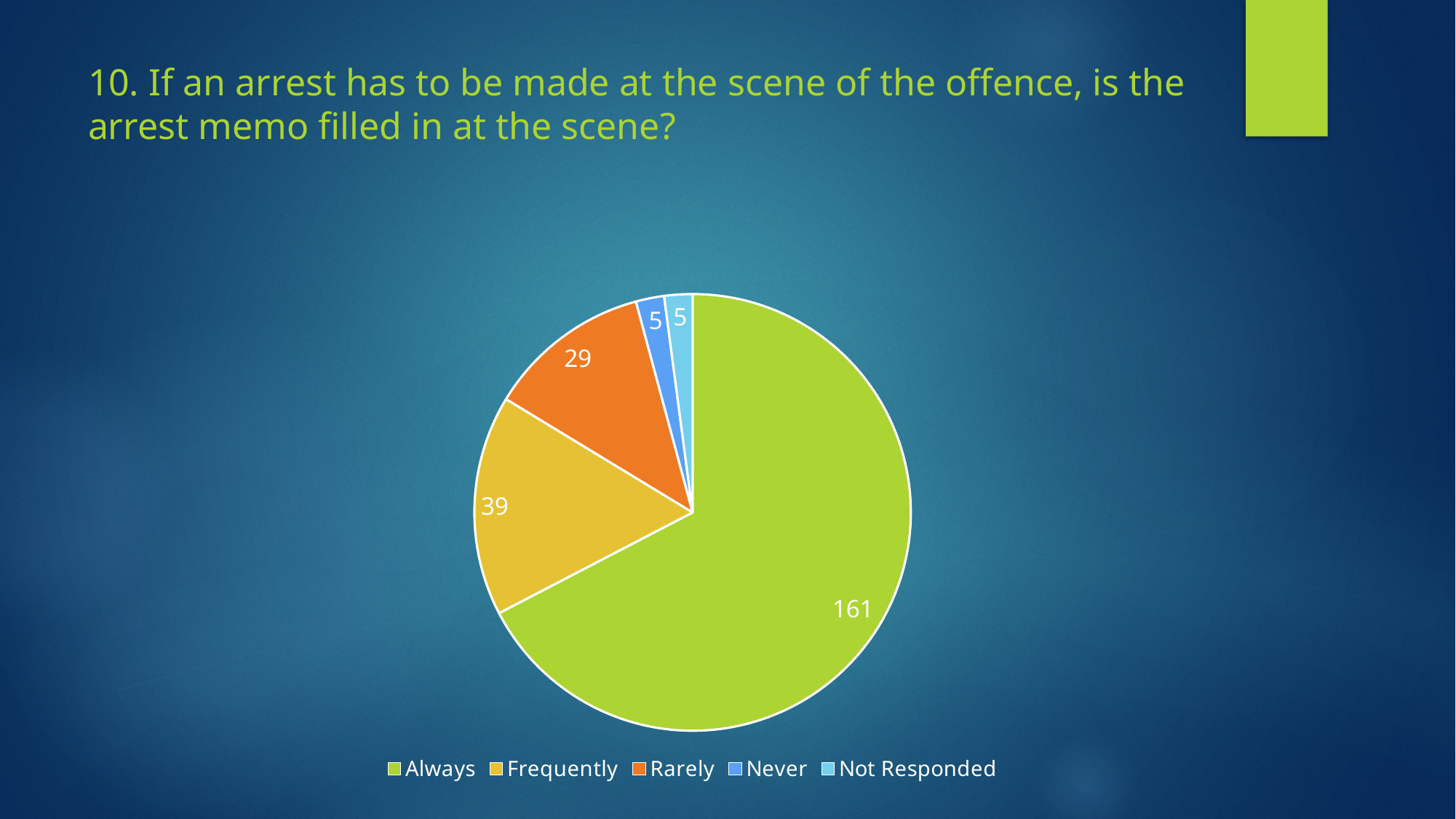
How many categories does the legend list? 5 What kind of chart is shown on the slide? pie chart What is the value for Rarely? 29 What is the value for Frequently? 39 What is the difference between the values for Frequently and Rarely? 10 Which category has the largest slice of the pie? Always Which colour represents the Rarely category in the pie chart? orange What is the total of all the slices in the pie? 239 What is the value for Always? 161 What is the difference between the values for Always and Frequently? 122 Which is larger, the value for Rarely or the value for Frequently? Frequently What is the value for Never? 5